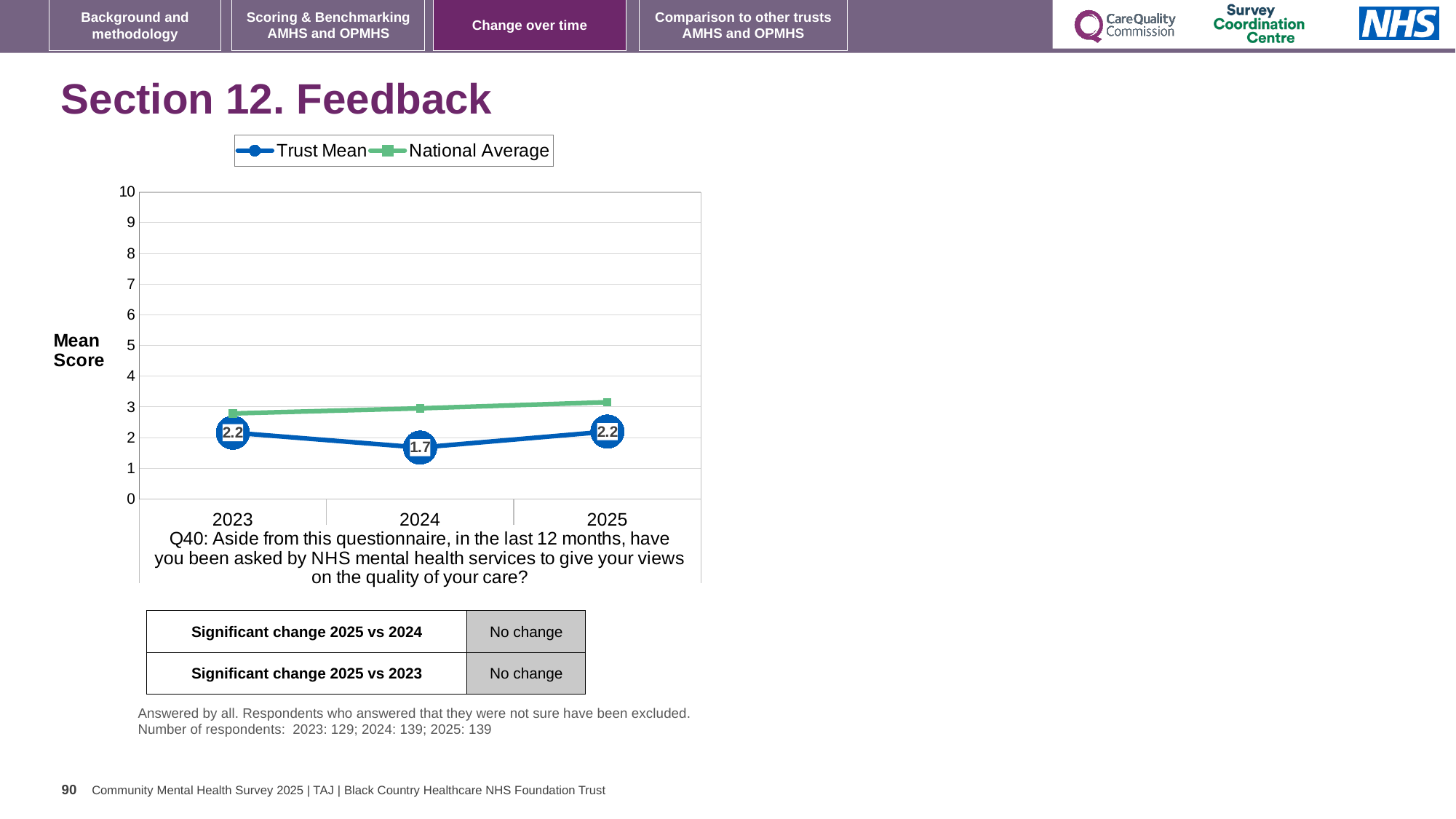
What is the Trust Mean value for 2023? 2.2 How many series does the chart legend list? 2 How many years are shown on the x axis of the chart? 3 In 2024, which is larger, the Trust Mean or the National Average? National Average Does the National Average rise or fall from 2023 to 2025? Rise Is the National Average value for 2023 greater or less than 3? less What is the Trust Mean value for 2025? 2.2 In which year is the Trust Mean lowest? 2024 Is the National Average value for 2025 greater or less than 3? greater What is the difference between the Trust Mean in 2023 and in 2024? 0.5 What is the Trust Mean value for 2024? 1.7 What kind of chart is shown on the slide? Line chart